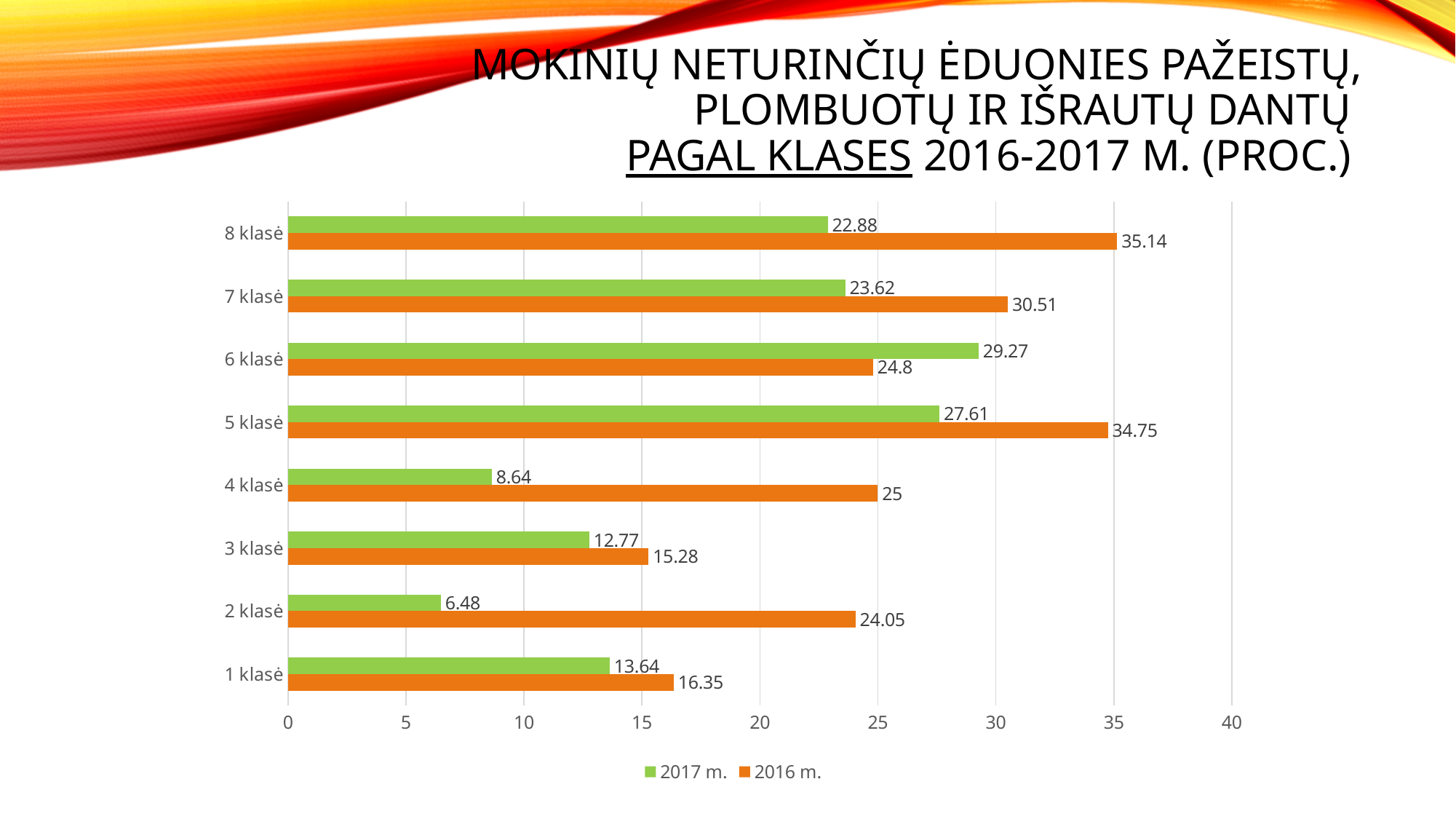
What is the difference between the 2016 m. and 2017 m. values for 4 klasė? 16.36 What type of chart is shown on the slide? bar chart Which class has the lowest value in the 2017 m. series? 2 klasė How many series does the legend list? 2 What is the value for 4 klasė in the 2017 m. series? 8.64 Which colour represents the 2016 m. series in the legend? orange For 6 klasė, which series has the larger value, 2017 m. or 2016 m.? 2017 m. Which class has the highest value in the 2017 m. series? 6 klasė Which class has the highest value in the 2016 m. series? 8 klasė How many classes (categories) are shown on the chart? 8 What is the value for 6 klasė in the 2016 m. series? 24.8 What is the value for 8 klasė in the 2016 m. series? 35.14